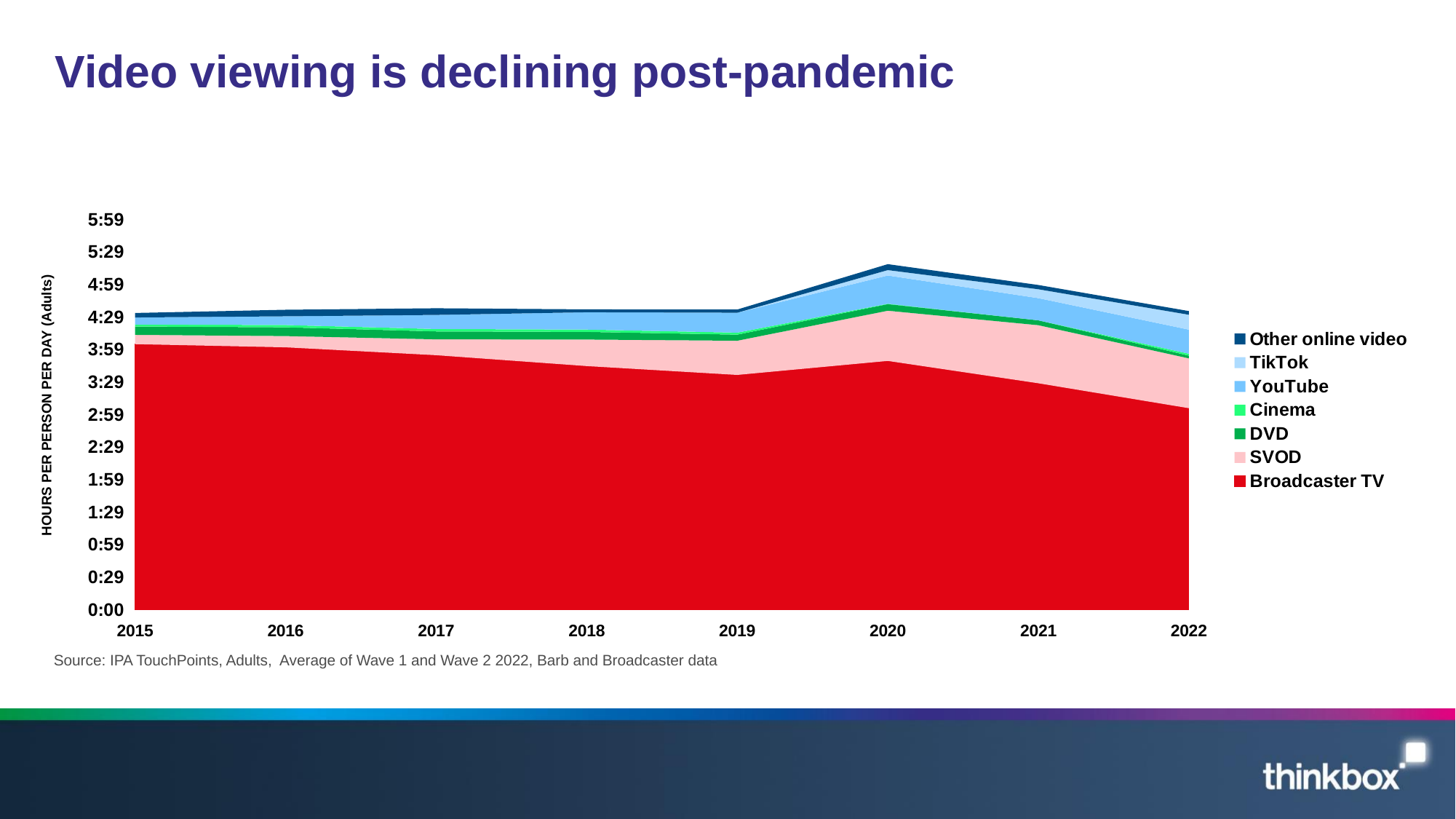
In which year is the total video viewing time highest? 2020 Is the Broadcaster TV value in 2022 greater or less than 3:29? less What is the title of the slide? Video viewing is declining post-pandemic Is the total viewing time in 2015 greater or less than 4:59? less How many years are plotted along the x axis? 8 What kind of chart is shown on the slide? Stacked area chart What is the label on the y axis? HOURS PER PERSON PER DAY (Adults) Is the Broadcaster TV value in 2020 greater or less than 3:29? greater How many series does the legend list? 7 Which series accounts for the largest share of viewing time in every year? Broadcaster TV How does total video viewing change from 2020 to 2022? It falls